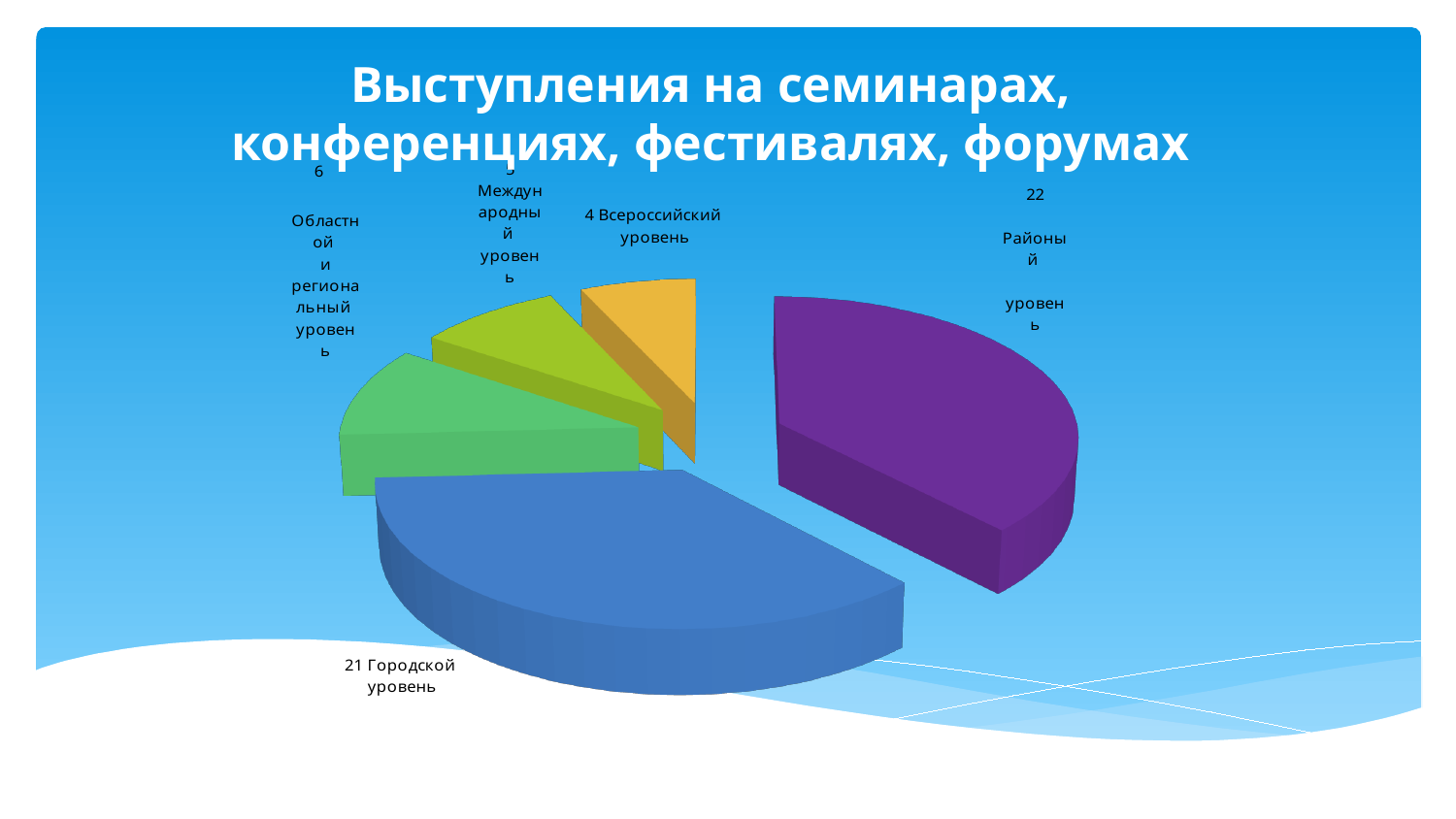
What is the difference between the values for Районый уровень and Городской уровень? 1 What kind of chart is shown on the slide? pie chart Which is larger, the value for Областной и региональный уровень or the value for Всероссийский уровень? Областной и региональный уровень What is the value for Городской уровень? 21 Which category has the largest value? Районый уровень Which category has the smallest value? Всероссийский уровень What is the value for Всероссийский уровень? 4 What is the value for Районый уровень? 22 What is the value for Областной и региональный уровень? 6 What is the title of the chart? Выступления на семинарах, конференциях, фестивалях, форумах How many slices does the pie chart have? 5 What is the difference between the values for Городской уровень and Всероссийский уровень? 17